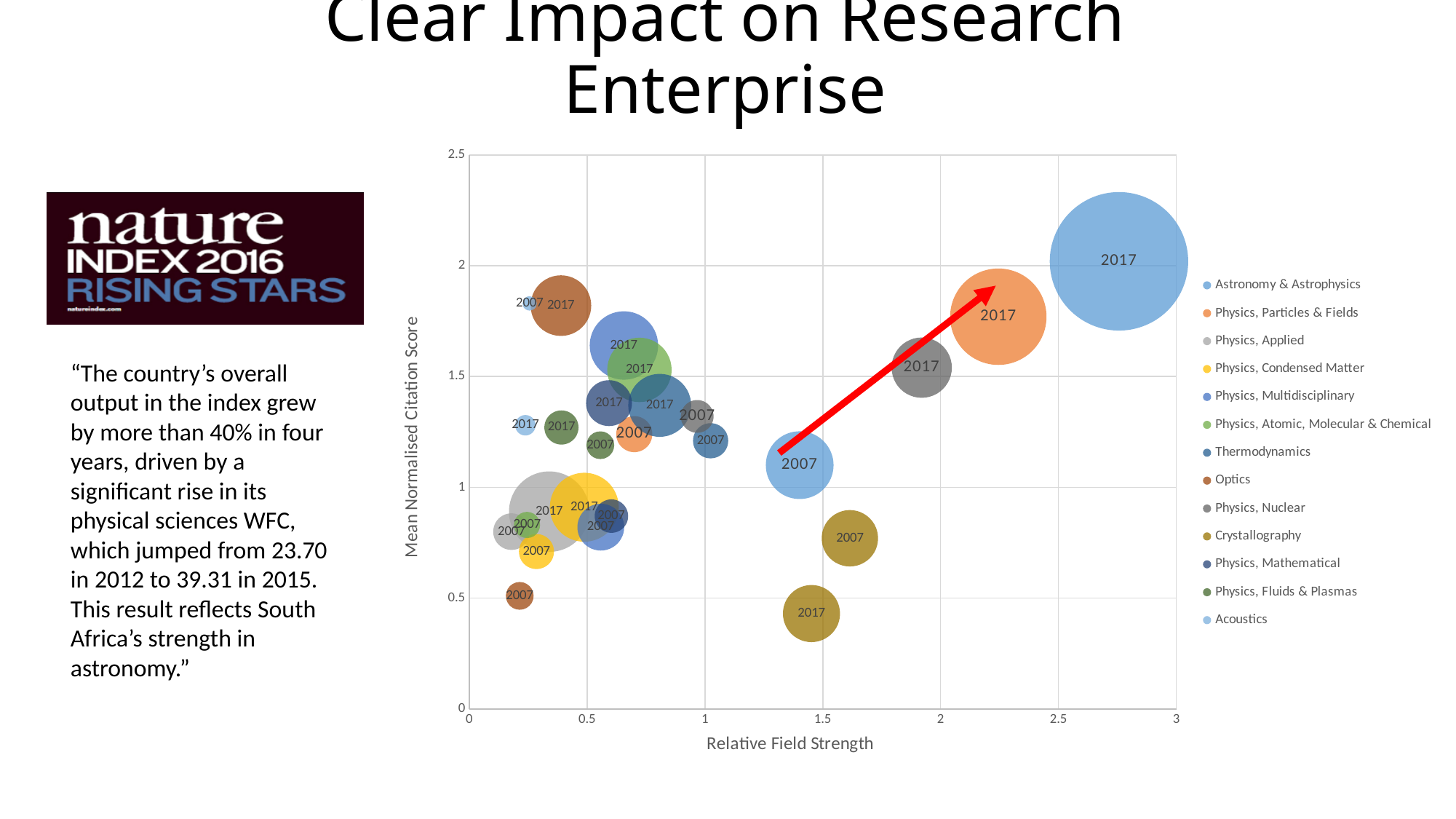
Is the Mean Normalised Citation Score of the Crystallography 2017 bubble greater or less than 0.5? less How many series does the chart legend list? 13 Is the Mean Normalised Citation Score of the Optics 2017 bubble greater or less than 1.5? greater Which bubble has the highest Mean Normalised Citation Score on the chart? Astronomy & Astrophysics 2017 Which bubble has the lowest Mean Normalised Citation Score on the chart? Crystallography 2017 What kind of chart is shown on the slide? bubble chart What is the title of the x axis of the chart? Relative Field Strength Is the Mean Normalised Citation Score of the Physics, Particles & Fields 2017 bubble greater or less than 1.5? greater For Astronomy & Astrophysics, which bubble has the higher Mean Normalised Citation Score, 2007 or 2017? 2017 What is the title of the y axis of the chart? Mean Normalised Citation Score